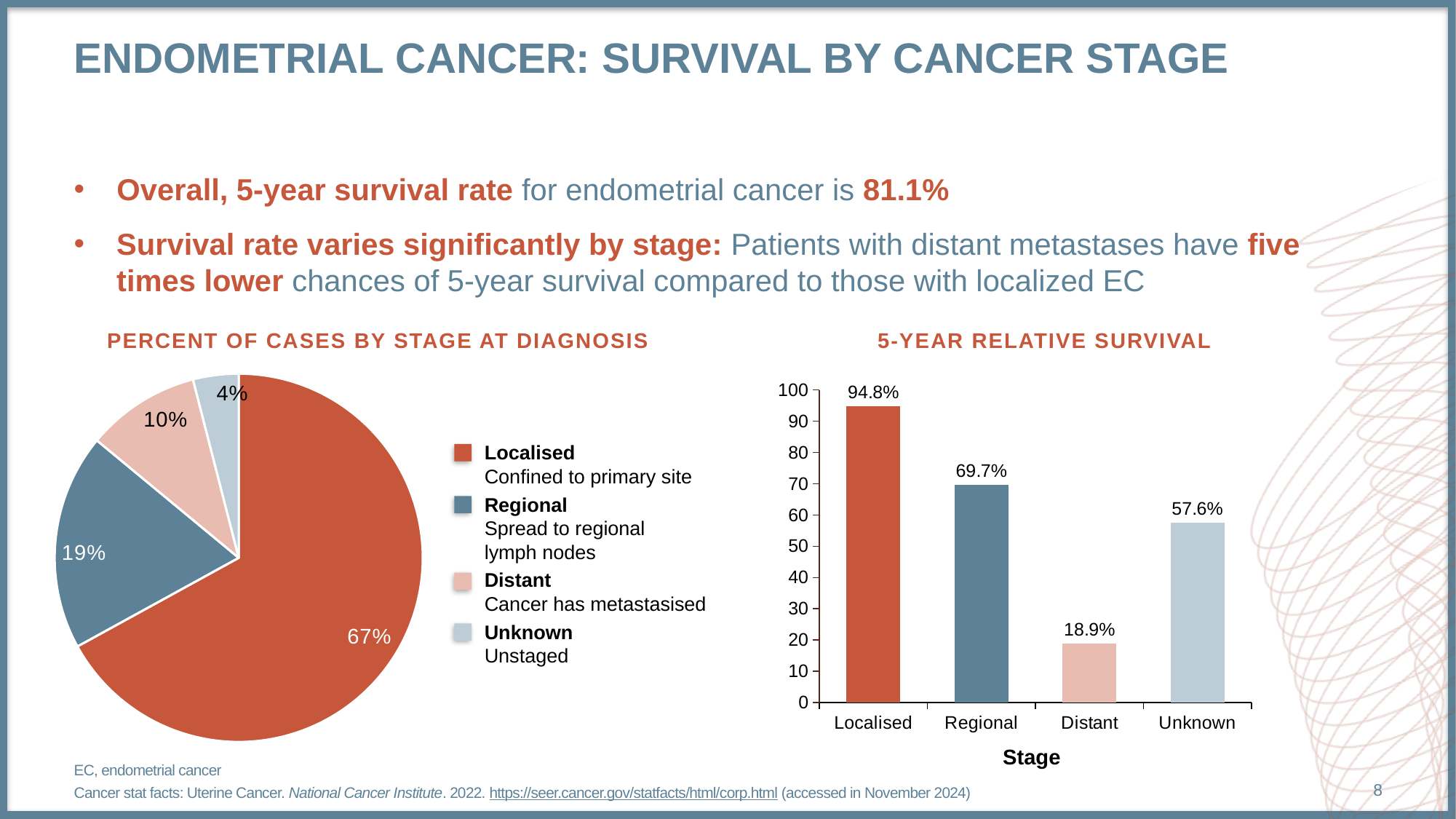
In the '5-year relative survival' chart, what is the label of the x axis? Stage What kind of chart is 'Percent of cases by stage at diagnosis'? Pie chart In the 'Percent of cases by stage at diagnosis' chart, how many stages are shown? 4 In the '5-year relative survival' chart, what is the difference between Localised and Distant? 75.9% In the 'Percent of cases by stage at diagnosis' chart, what percentage of cases are Localised? 67% In the '5-year relative survival' chart, which is larger, Regional or Unknown? Regional What kind of chart is '5-year relative survival'? Bar chart In the '5-year relative survival' chart, what is the value for Unknown? 57.6% In the '5-year relative survival' chart, which stage has the highest survival? Localised In the 'Percent of cases by stage at diagnosis' chart, which stage has the smallest share? Unknown In the '5-year relative survival' chart, what is the value for Distant? 18.9% In the 'Percent of cases by stage at diagnosis' chart, what percentage of cases are Regional? 19%